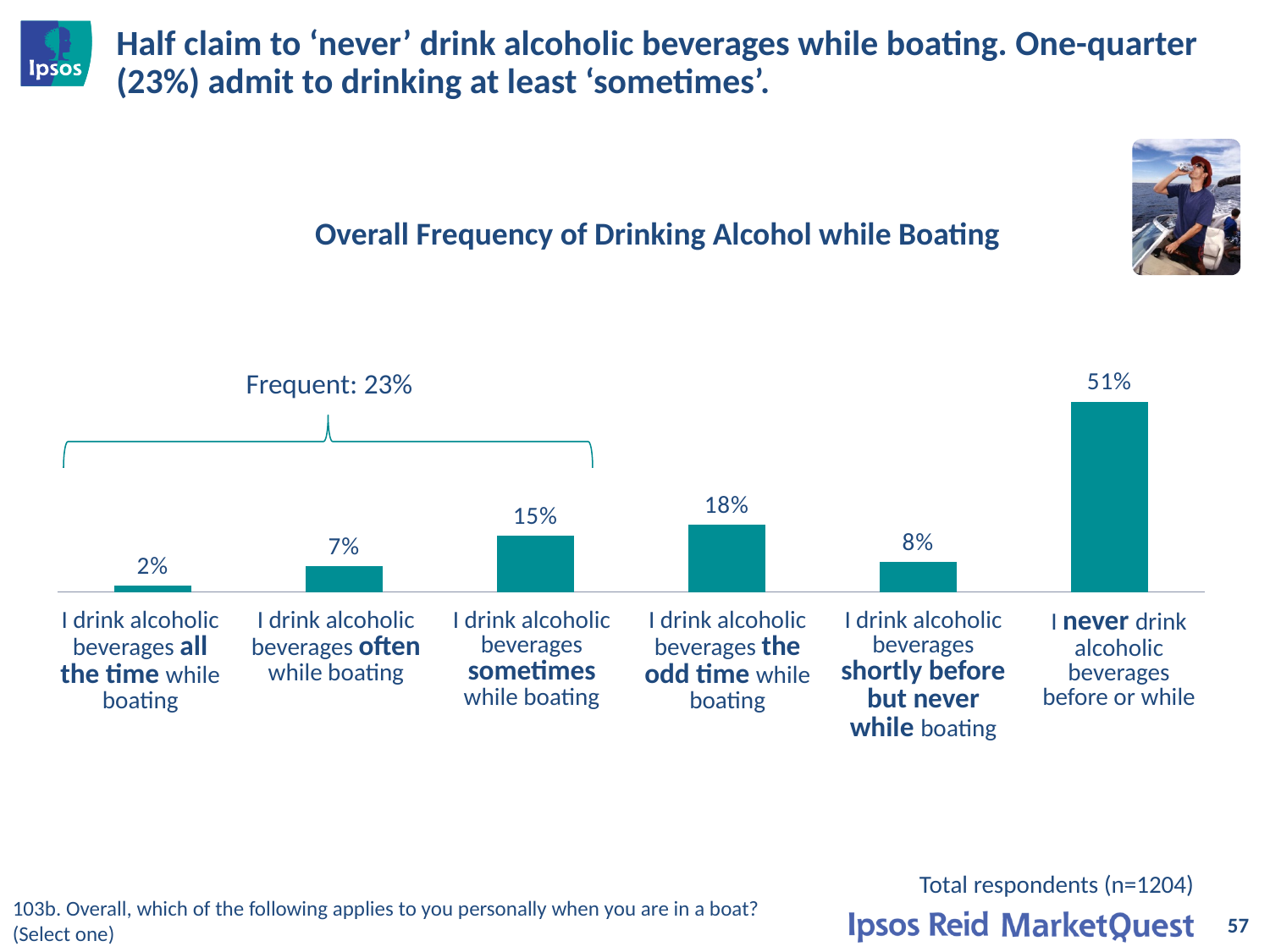
What is the combined percentage labelled as 'Frequent' on the chart? 23% What percentage of respondents say they drink alcoholic beverages all the time while boating? 2% Which is larger: the percentage who drink sometimes while boating or the percentage who drink often while boating? Sometimes while boating What percentage of respondents say they drink alcoholic beverages shortly before but never while boating? 8% Which category has the lowest percentage of respondents? I drink alcoholic beverages all the time while boating What percentage of respondents say they drink alcoholic beverages the odd time while boating? 18% What is the title of the chart? Overall Frequency of Drinking Alcohol while Boating What percentage of respondents say they never drink alcoholic beverages before or while boating? 51% Which category has the highest percentage of respondents? I never drink alcoholic beverages before or while What type of chart is shown on the slide? Bar chart What is the difference in percentage points between those who never drink while boating and those who drink the odd time while boating? 33 How many categories are shown in the chart? 6